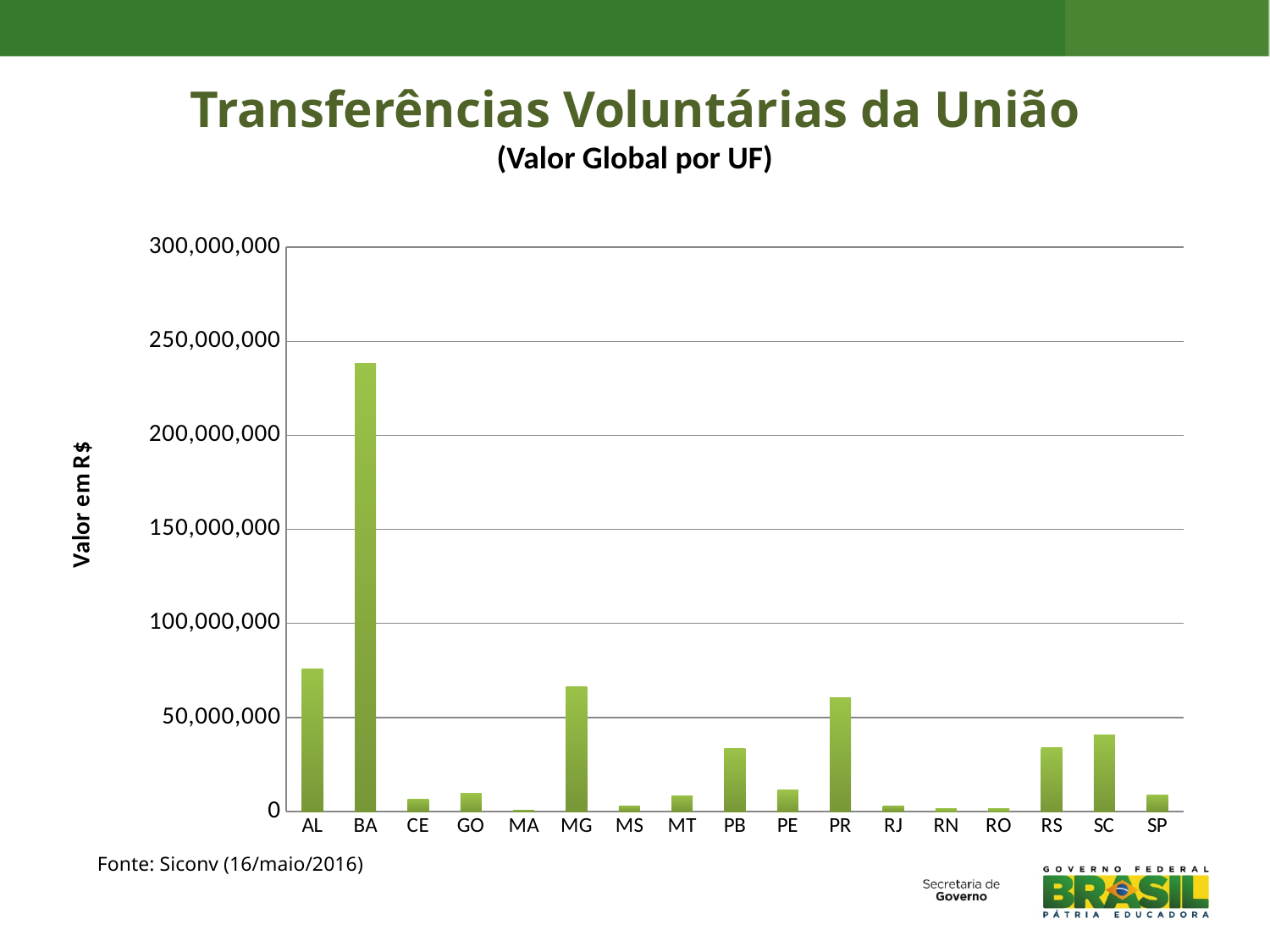
Which UF has the highest value? BA Is the value for BA greater or less than 200,000,000? greater What kind of chart is shown on the slide? bar chart Which is larger, the value for PB or the value for PE? PB Is the value for SC greater or less than 50,000,000? less Is the value for MG greater or less than 100,000,000? less Which is larger, the value for PR or the value for SC? PR What is the label of the vertical axis? Valor em R$ What source is cited below the chart? Siconv (16/maio/2016) How many UF categories are plotted on the x axis? 17